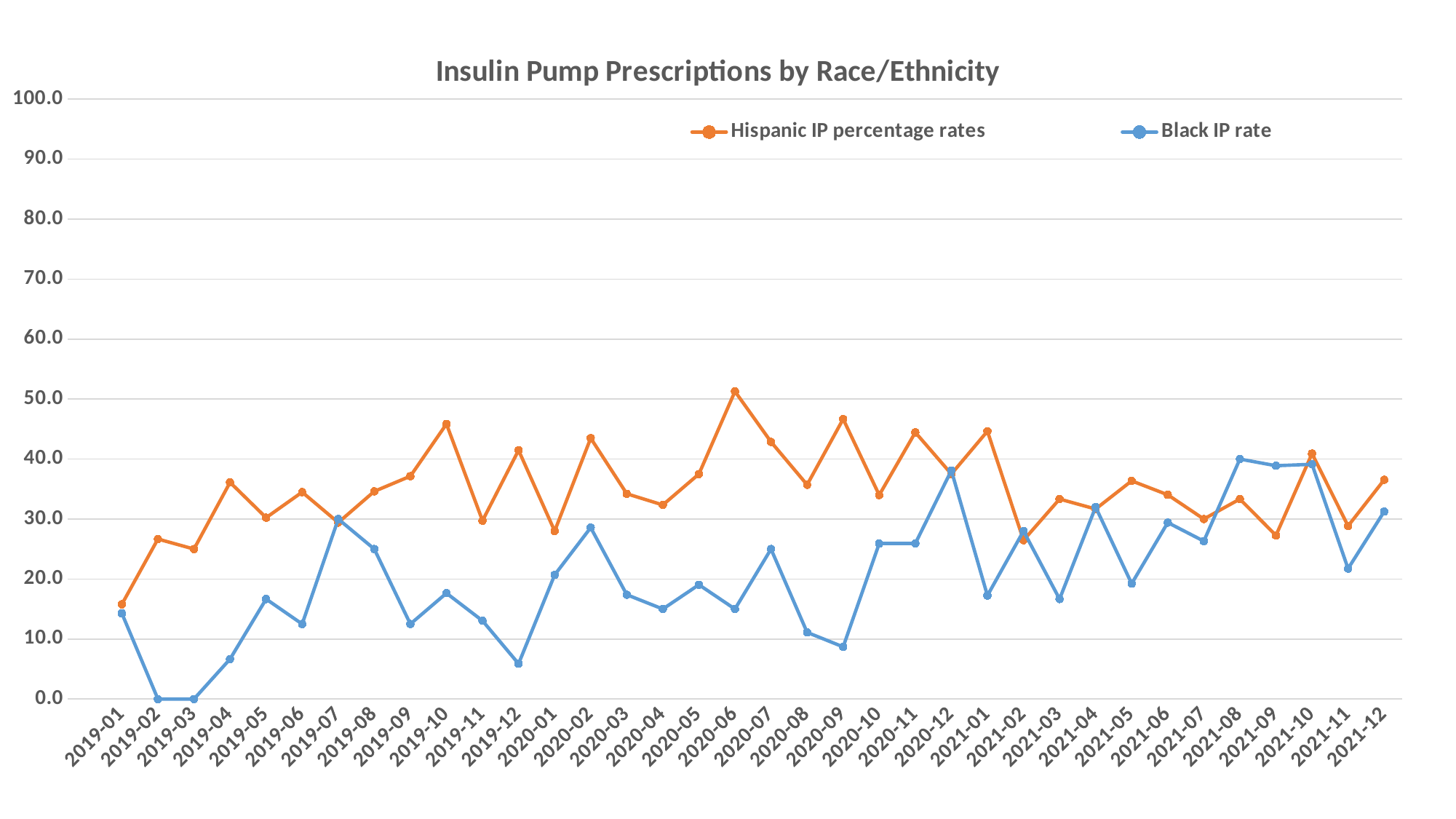
Which series has the larger value in 2020-06, Hispanic IP percentage rates or Black IP rate? Hispanic IP percentage rates Which series is drawn in orange? Hispanic IP percentage rates Is the Black IP rate in 2019-12 greater or less than 10? less In which month does the Hispanic IP percentage rate reach its highest value? 2020-06 How many series does the legend list? 2 What kind of chart is shown on the slide? Line chart What is the lowest value of the Black IP rate series? 0.0 What is the Black IP rate in 2019-02? 0.0 Is the Hispanic IP percentage rate in 2020-06 greater or less than 40? greater Which series has the larger value in 2021-08, Hispanic IP percentage rates or Black IP rate? Black IP rate How many monthly points are plotted along the x axis? 36 What is the title of the chart? Insulin Pump Prescriptions by Race/Ethnicity